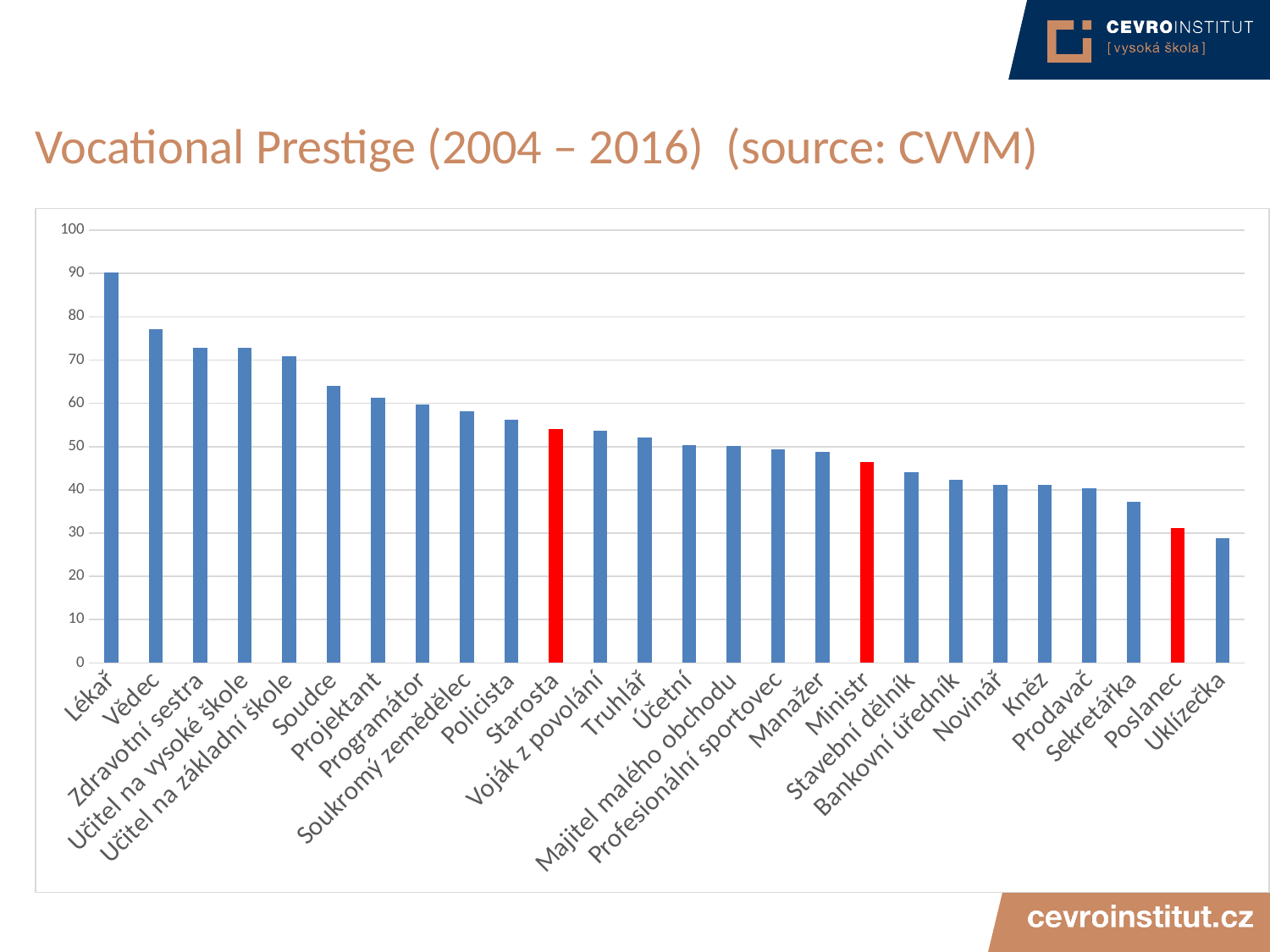
Which three categories are shown with red bars? Starosta, Ministr, Poslanec How many categories are plotted on the x axis? 26 Which category has the lowest value? Uklízečka Is the value for Uklízečka greater or less than 40? less What kind of chart is shown on the slide? bar chart Is the value for Ministr greater or less than 50? less Is the value for Starosta greater or less than 50? greater Do the values generally rise or fall from left to right along the x axis? fall Which is larger, the value for Starosta or the value for Ministr? Starosta Which category has the highest value? Lékař